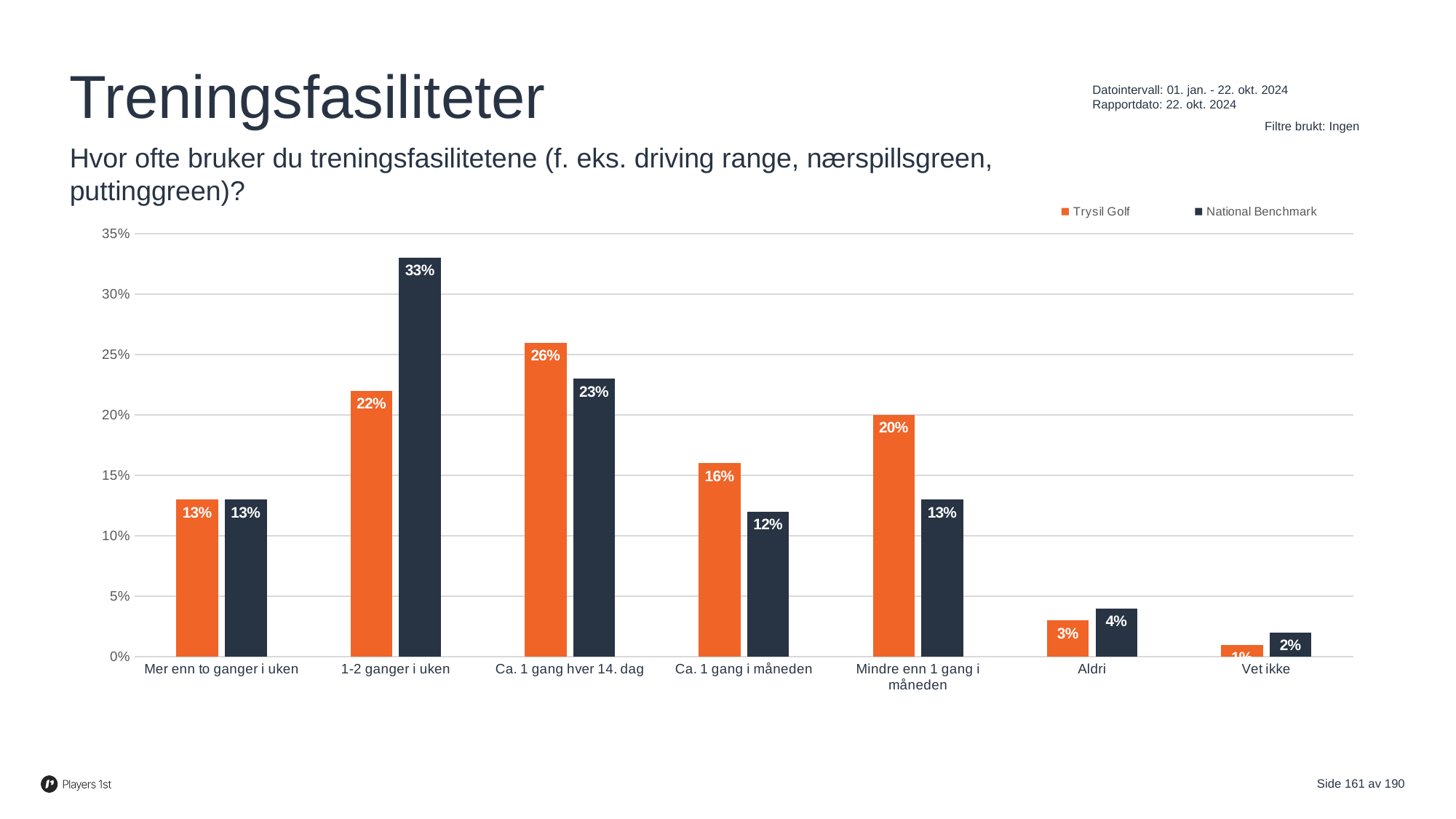
How many categories are shown on the x axis? 7 Which category has the highest National Benchmark value? 1-2 ganger i uken For "Ca. 1 gang i måneden", which series has the larger value, Trysil Golf or National Benchmark? Trysil Golf What is the National Benchmark value for "Ca. 1 gang hver 14. dag"? 23% What is the Trysil Golf value for "Mindre enn 1 gang i måneden"? 20% Which category has the lowest Trysil Golf value? Vet ikke What is the National Benchmark value for "Aldri"? 4% What kind of chart is shown on the slide? Bar chart What is the difference between the National Benchmark and Trysil Golf values for "1-2 ganger i uken"? 11% Which colour represents Trysil Golf in the legend? Orange What is the Trysil Golf value for "1-2 ganger i uken"? 22% How many series does the legend list? 2